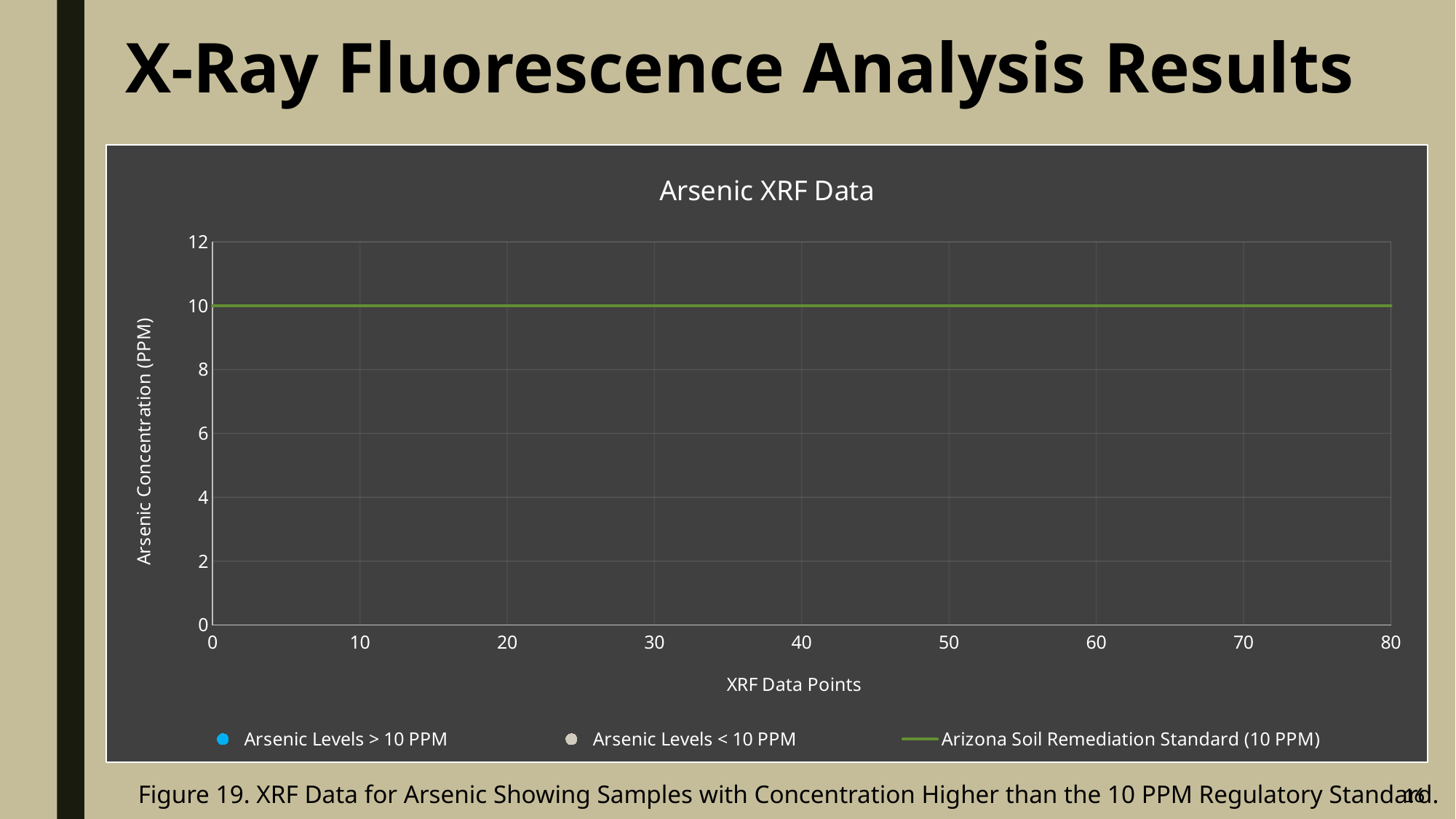
At what value does the Arizona Soil Remediation Standard line sit on the y axis? 10 Is the Arizona Soil Remediation Standard line greater or less than 8 on the y axis? greater What is the maximum value shown on the x axis? 80 Does the Arizona Soil Remediation Standard line rise, fall, or stay flat across the x axis? stay flat What is the label of the y axis? Arsenic Concentration (PPM) What is the title of the chart? Arsenic XRF Data How many series does the chart legend list? 3 What is the maximum value shown on the y axis? 12 Is the Arizona Soil Remediation Standard line greater or less than 12 on the y axis? less